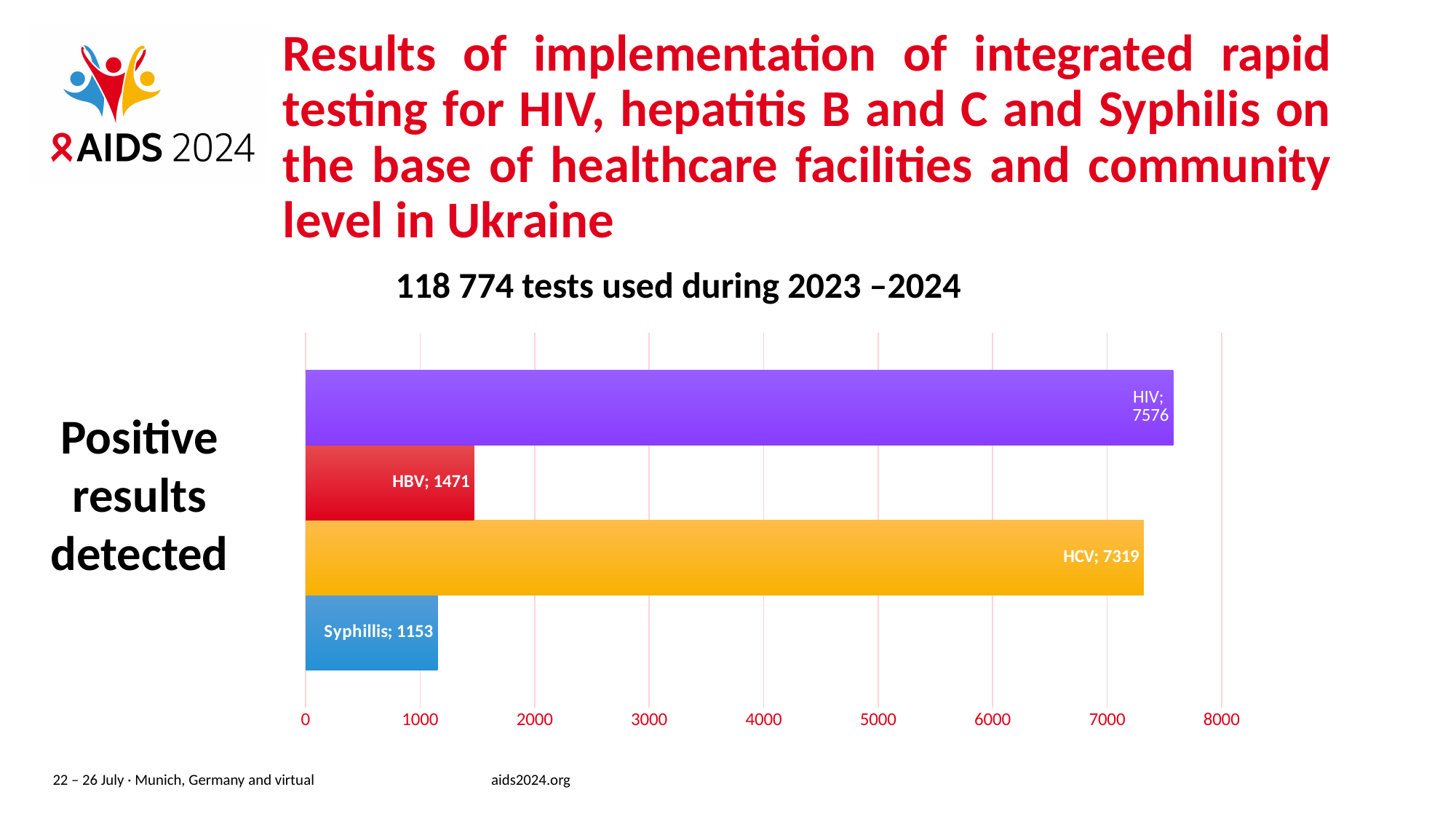
Which category has the highest number of positive results? HIV What kind of chart is shown on the slide? bar chart Which is larger, the value for HBV or the value for Syphillis? HBV What is the difference between the HIV and HCV positive results? 257 Is the value for HCV greater or less than 7000? greater What is the difference between the HBV and Syphillis positive results? 318 Which category has the lowest number of positive results? Syphillis What is the number of positive HCV results detected? 7319 How many categories are shown in the chart? 4 What is the number of positive HIV results detected? 7576 What is the number of positive HBV results detected? 1471 What is the number of positive Syphillis results detected? 1153